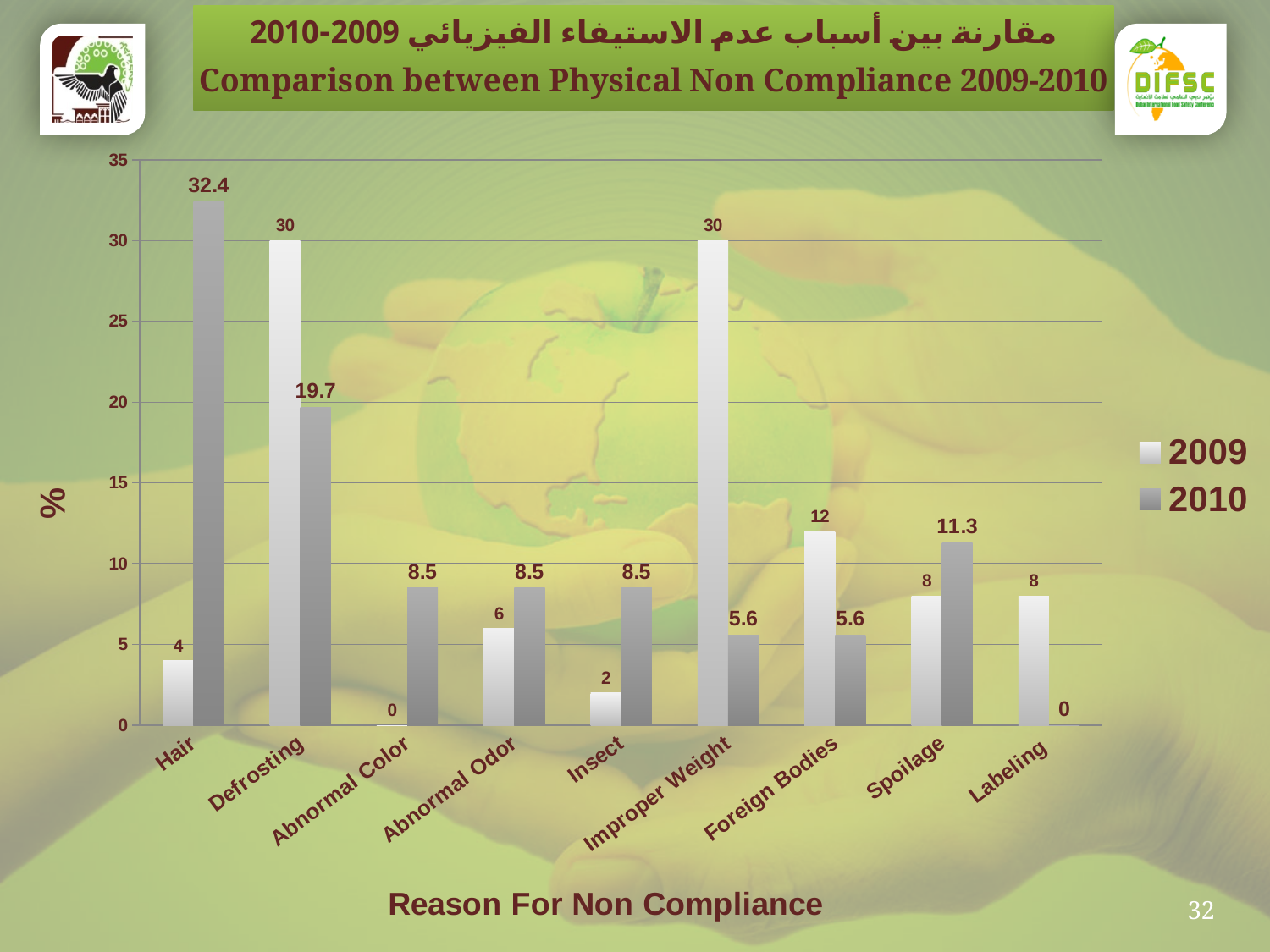
What is the label of the x axis? Reason For Non Compliance Which category has the highest 2010 value? Hair What is the 2009 value for Foreign Bodies? 12 Which category has the lowest 2010 value? Labeling How many categories are shown on the x axis? 9 What is the 2010 value for Hair? 32.4 What is the difference between the 2009 and 2010 values for Defrosting? 10.3 What kind of chart is shown on the slide? Bar chart What is the 2009 value for Defrosting? 30 What is the 2010 value for Spoilage? 11.3 Which is larger for Improper Weight, the 2009 value or the 2010 value? 2009 How many series does the legend list? 2